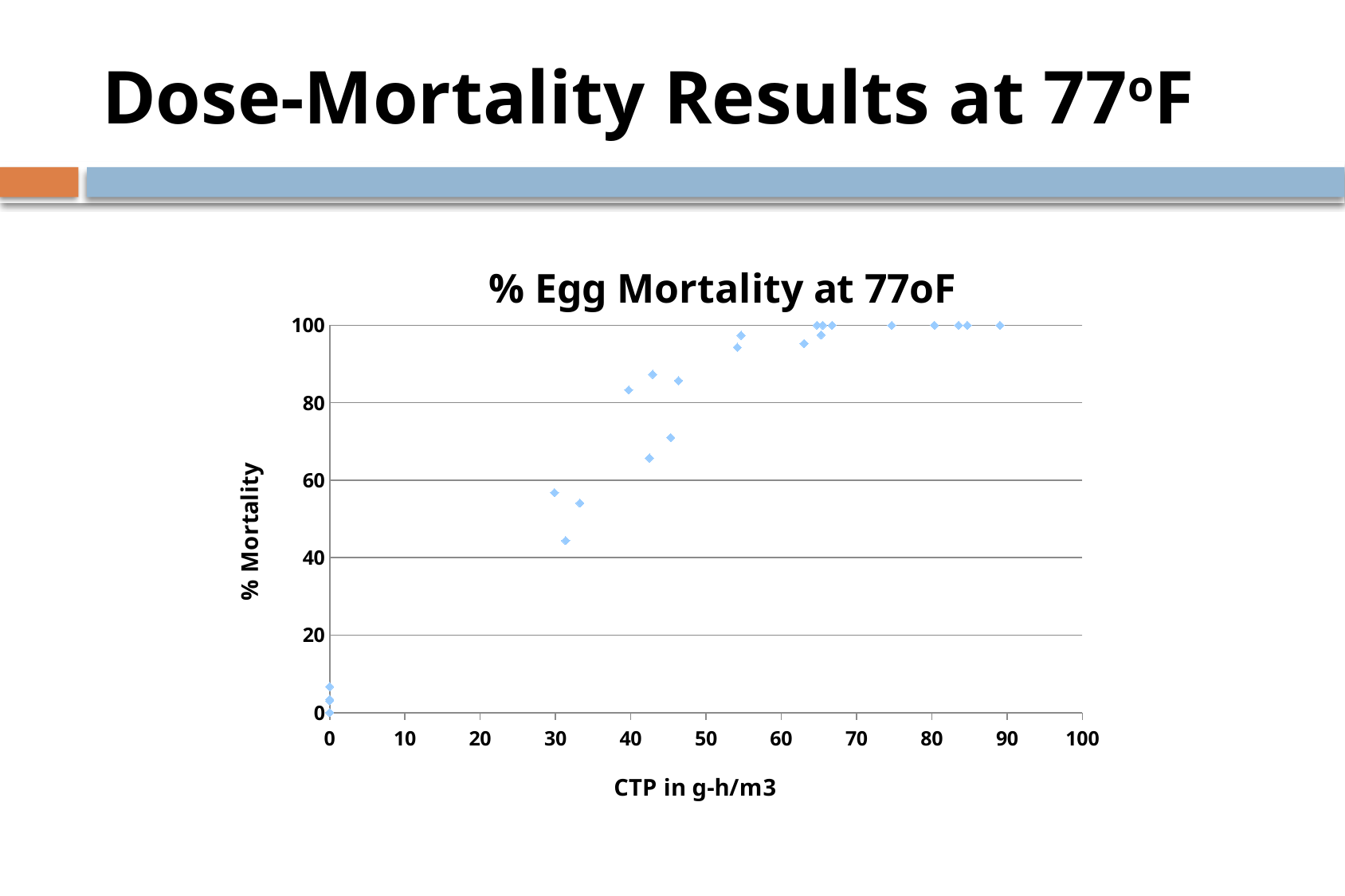
What is the highest value shown on the y axis of the chart? 100 Is the % Mortality for the points near 0 CTP greater or less than 20? less Do the % Mortality values generally rise or fall as CTP increases along the x axis? rise Is the % Mortality for the points at about 55 CTP greater or less than 80? greater What is the label of the x axis of the chart? CTP in g-h/m3 Is the % Mortality for the point at about 30 CTP greater or less than 40? greater What is the title of the chart? % Egg Mortality at 77oF What kind of chart is shown on the slide? scatter chart Which has the higher % Mortality: the point at about 40 CTP or the point at about 30 CTP? the point at about 40 CTP What is the % Mortality value of the rightmost point on the chart (at about 89 CTP)? 100